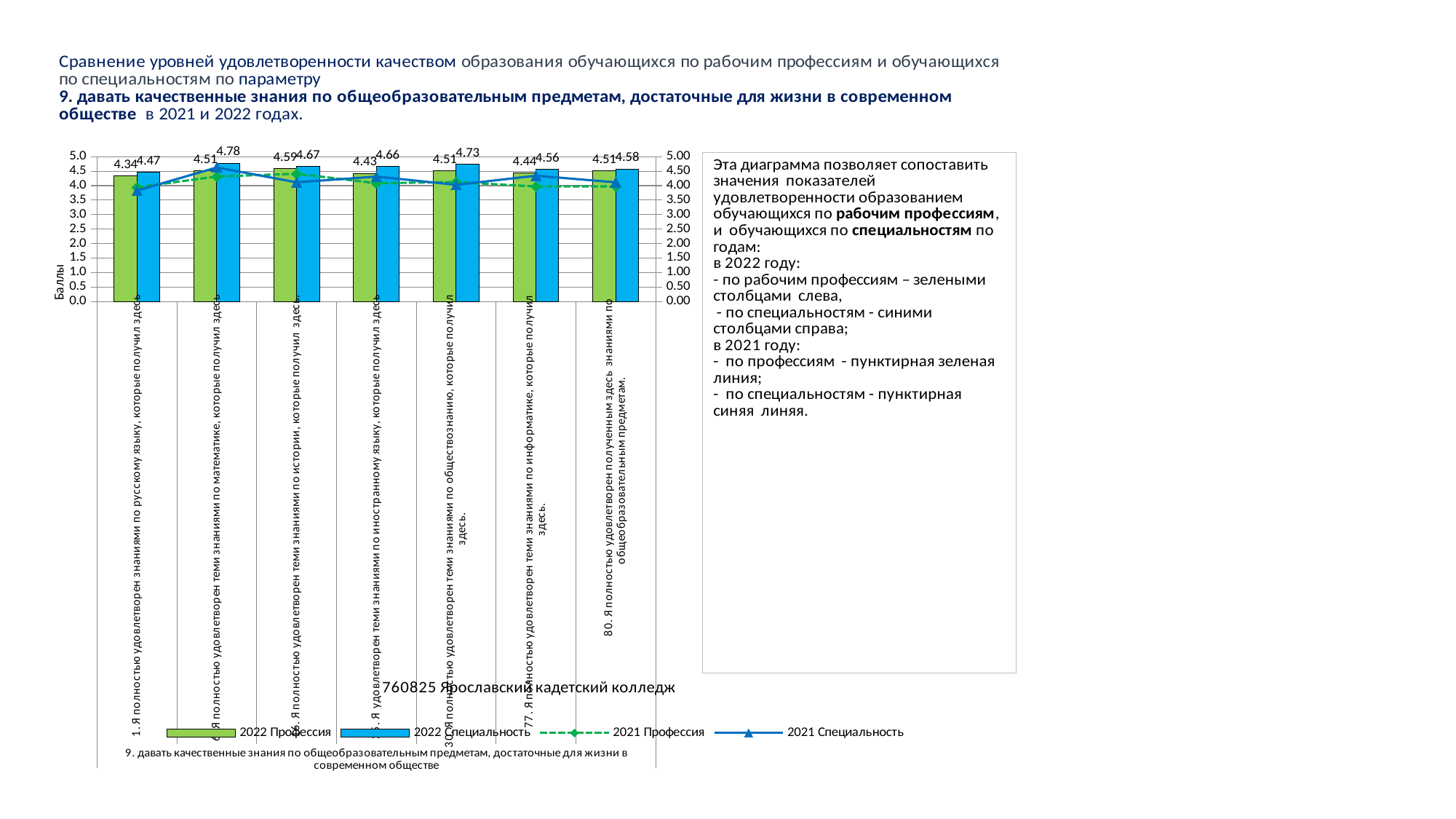
How many series does the chart legend list? 4 What type of chart is used to show the 2022 Профессия and 2022 Специальность series? Bar chart Which category has the lowest 2022 Профессия value? Русский язык (4.34) For the category about история, which is larger: the 2022 Профессия value or the 2022 Специальность value? 2022 Специальность (4.67) What is the 2022 Специальность value for the category about knowledge of математика? 4.78 What is the difference between the 2022 Специальность and 2022 Профессия values for математика? 0.27 Which category has the highest 2022 Специальность value? Математика (4.78) What is the 2022 Профессия value for category 80 (общеобразовательные предметы)? 4.51 Is the 2021 Специальность value for the русский язык category greater or less than 3.5? greater What is the 2022 Профессия value for the category about knowledge of русский язык (category 1)? 4.34 How many categories are shown on the x axis of the chart? 7 What is the 2022 Специальность value for the category about knowledge of информатика? 4.56